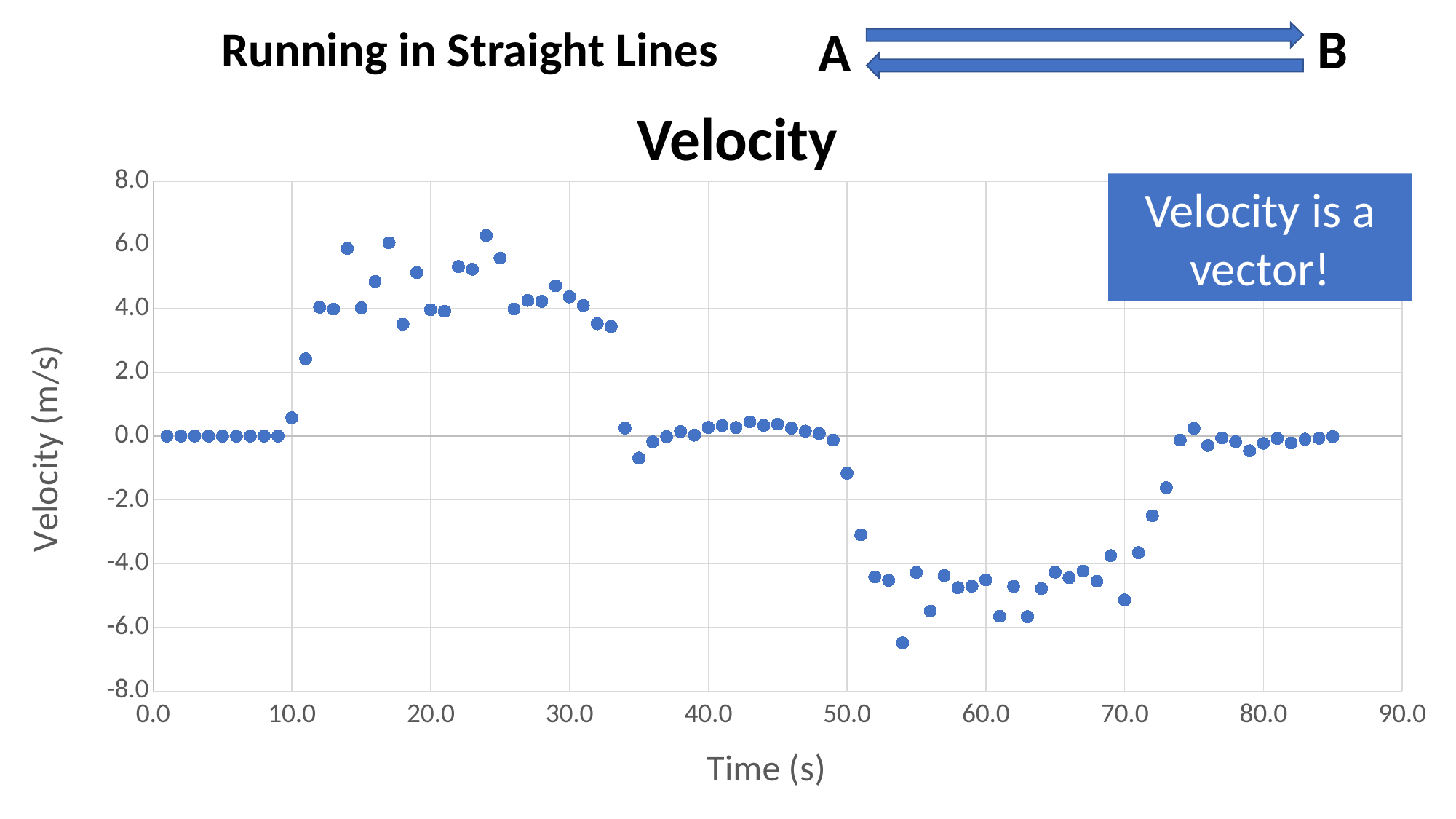
What is the title of the chart? Velocity Is the velocity value at 11 s greater or less than 2.0? greater Do the velocity values rise or fall between 10 s and 14 s? rise Which is larger, the velocity value at 20 s or the velocity value at 60 s? 20 s Is the velocity value at 35 s greater or less than 0.0? less Is the velocity value at 72 s greater or less than -2.0? less What is the label of the vertical axis of the chart? Velocity (m/s) Do the velocity values rise or fall between 49 s and 54 s? fall What kind of chart is shown on the slide? Scatter chart